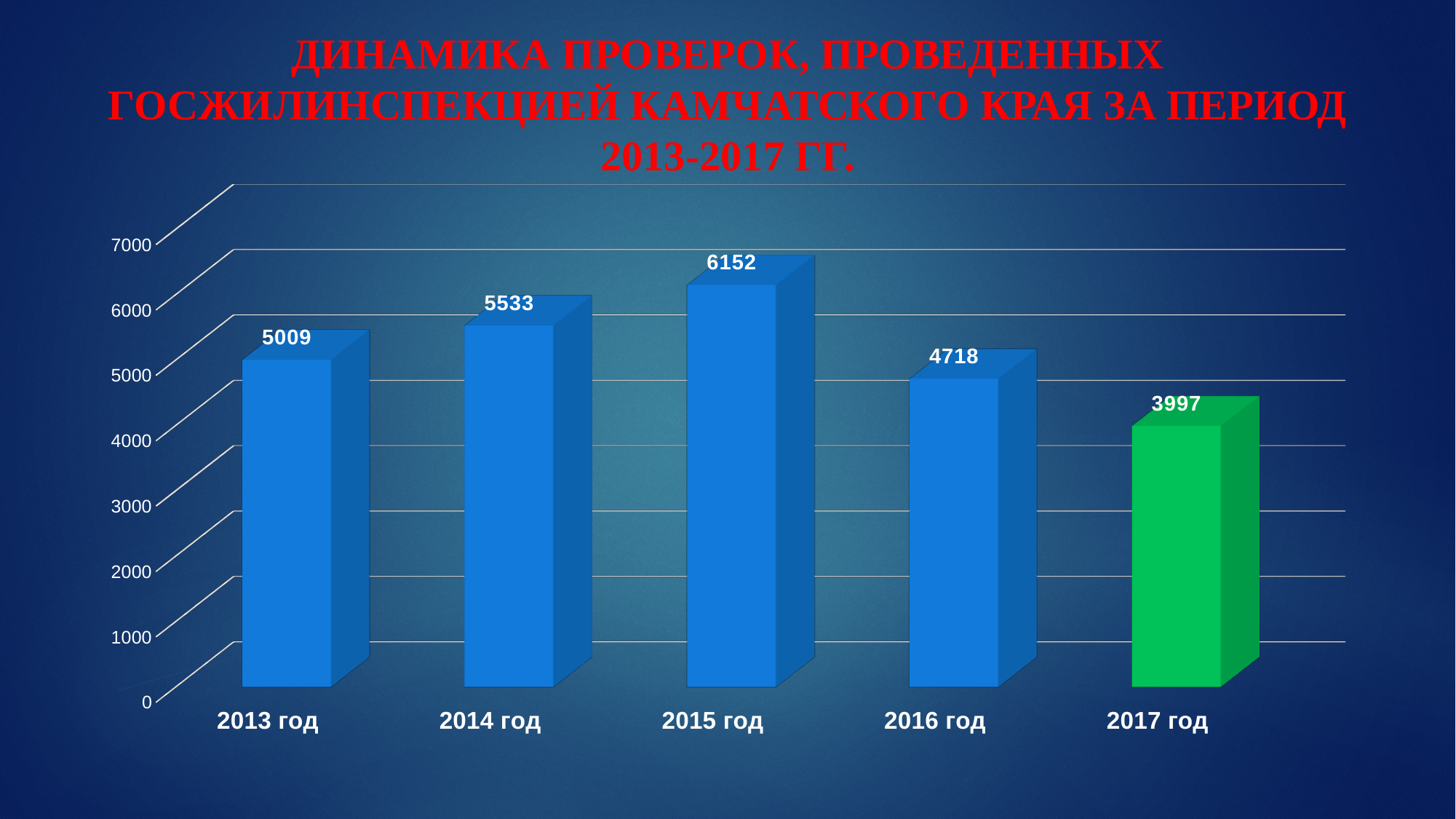
Which year has the highest value? 2015 год What is the difference between the values for 2015 год and 2016 год? 1434 Is the value for 2014 год greater or less than 5000? greater What is the difference between the values for 2014 год and 2013 год? 524 Which is larger, the value for 2016 год or the value for 2017 год? 2016 год What kind of chart is shown on the slide? bar chart Which year has the lowest value? 2017 год Which bar is coloured green rather than blue? 2017 год How many years are shown on the chart? 5 What is the value for 2015 год? 6152 What is the value for 2013 год? 5009 What is the value for 2017 год? 3997